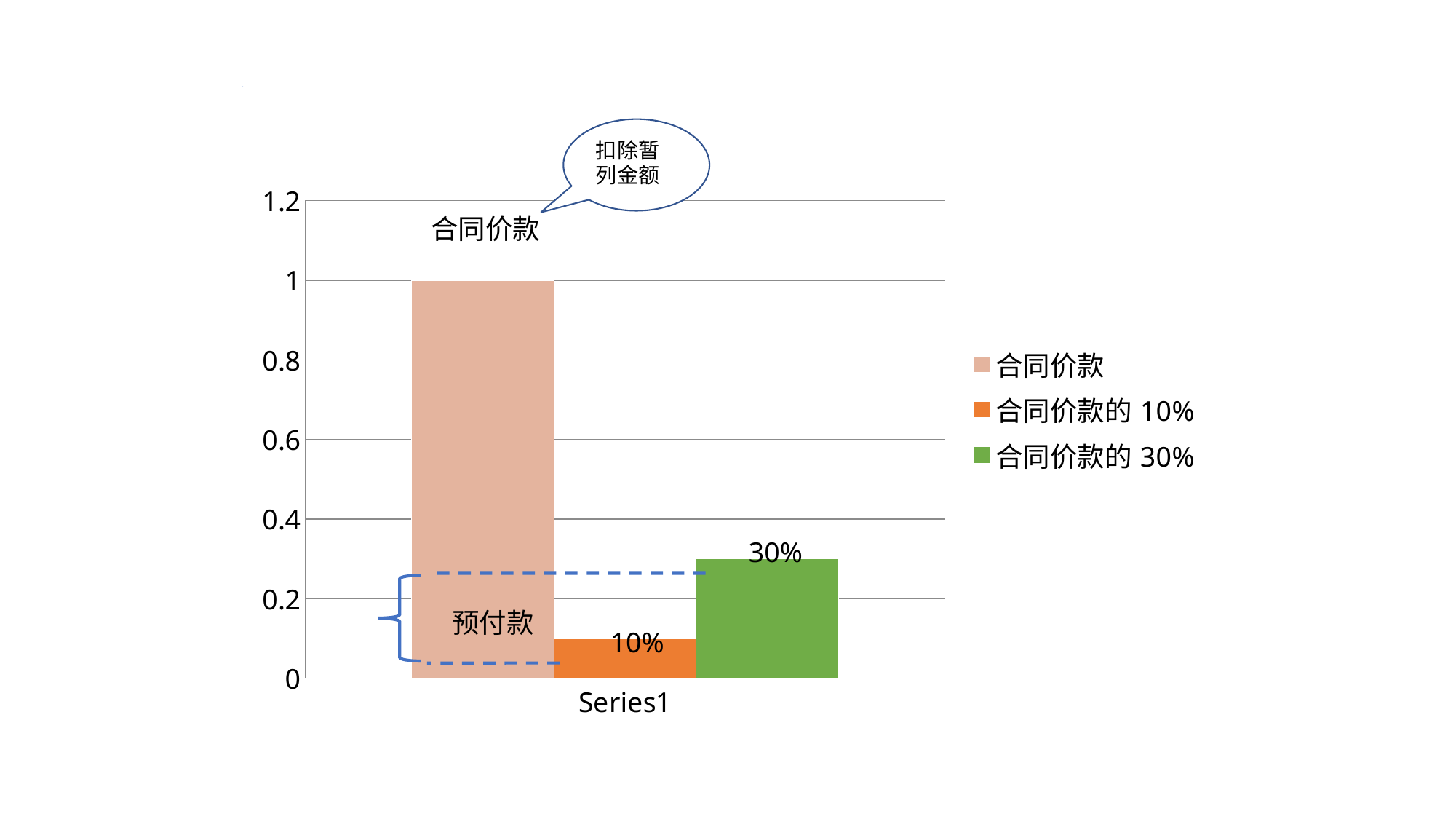
What is the data label on the bar for 合同价款的 30%? 30% Which series has the shortest bar? 合同价款的 10% What is the difference between the labelled values of 合同价款的 30% and 合同价款的 10%? 20% Which is larger, the bar for 合同价款的 30% or the bar for 合同价款的 10%? 合同价款的 30% What is the category label shown on the horizontal axis? Series1 What value does the 合同价款 bar reach on the vertical axis? 1 What is the data label on the bar for 合同价款的 10%? 10% How many series does the legend list? 3 Which series has the tallest bar? 合同价款 Is the value for 合同价款的 30% greater or less than 0.4? less What kind of chart is shown on the slide? bar chart What colour is the bar for 合同价款的 30%? green